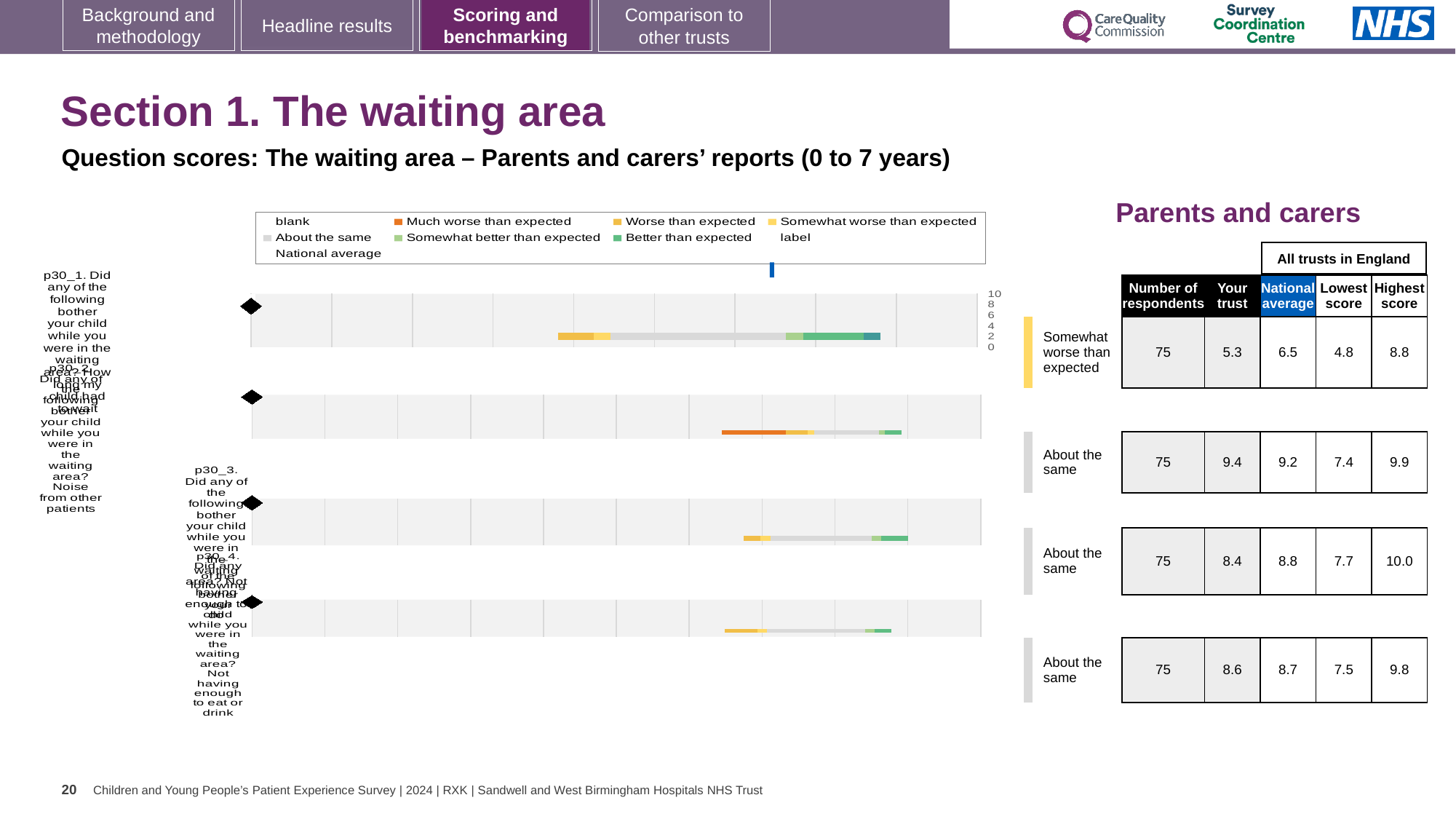
In the table, is the 'Your trust' score for the second question (9.4) larger or smaller than its National average (9.2)? larger In the table, what is the 'Your trust' score for the first question (Somewhat worse than expected)? 5.3 What kind of chart is shown on the left of the slide? bar chart In the table, what is the difference between the National average (6.5) and Your trust (5.3) for the first question? 1.2 In the table, what is the Highest score for the third question (About the same, Your trust 8.4)? 10.0 How many horizontal bars (questions) are plotted in the chart? 4 What is the title of the table to the right of the chart? Parents and carers Which legend entry is shown in orange in the chart? Much worse than expected How many entries does the chart legend list? 9 In the table, which question has the lowest 'Your trust' score? the first question (5.3) In the table, which question has the highest 'Your trust' score? the second question (9.4) In the table, what is the National average for the first question (Somewhat worse than expected)? 6.5